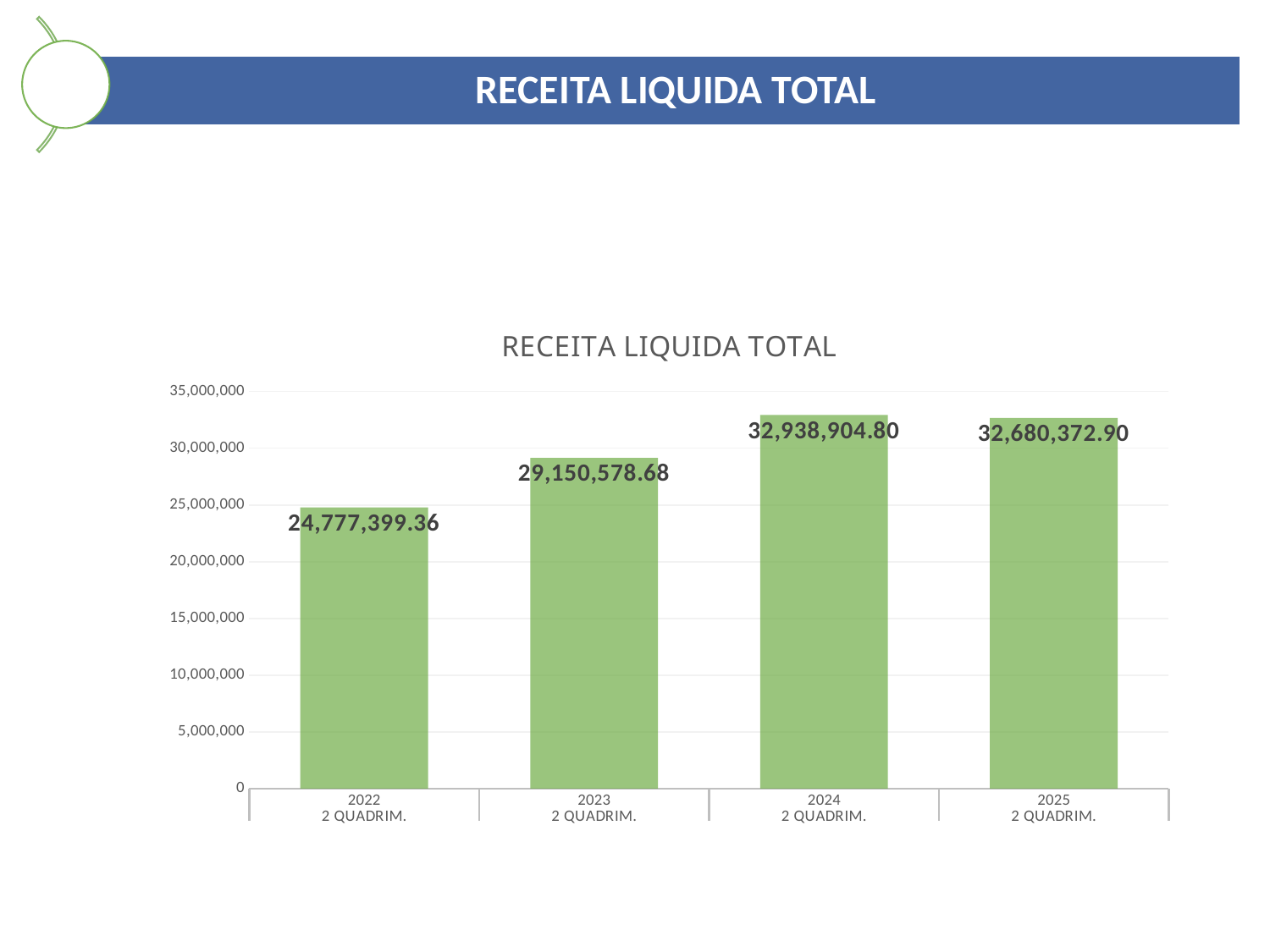
What is the value for 2022 2 QUADRIM.? 24,777,399.36 What is the value for 2023 2 QUADRIM.? 29,150,578.68 What kind of chart is this? Bar chart What is the difference between the values for 2024 2 QUADRIM. and 2025 2 QUADRIM.? 258,531.90 What is the title of the chart? RECEITA LIQUIDA TOTAL Which category has the lowest value? 2022 2 QUADRIM. What is the value for 2025 2 QUADRIM.? 32,680,372.90 What is the difference between the values for 2023 2 QUADRIM. and 2022 2 QUADRIM.? 4,373,179.32 Which category has the highest value? 2024 2 QUADRIM. Which is larger, the value for 2022 2 QUADRIM. or 2023 2 QUADRIM.? 2023 2 QUADRIM. What is the value for 2024 2 QUADRIM.? 32,938,904.80 How many categories are shown on the x axis? 4